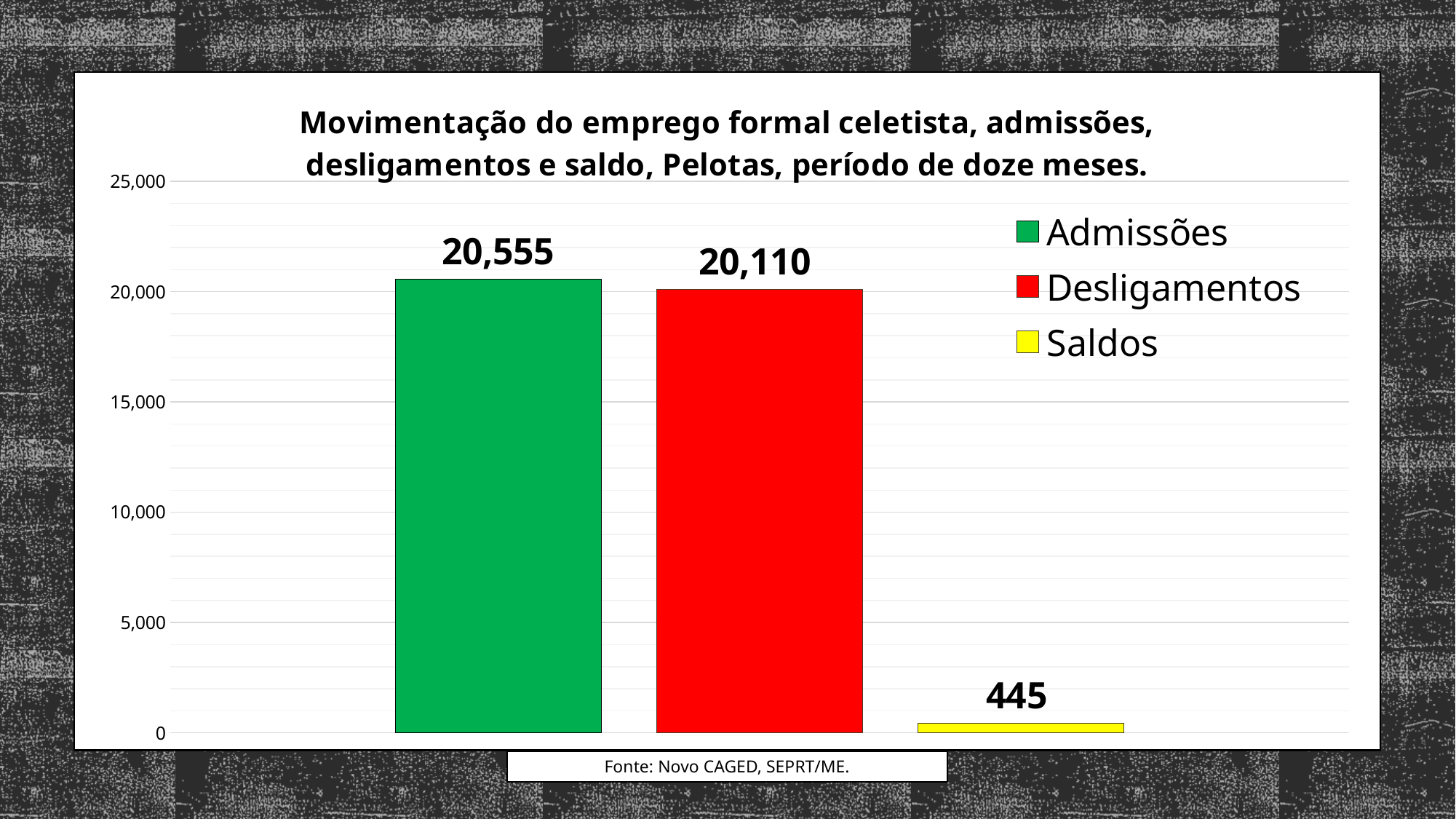
Is the value for Desligamentos greater or less than 15,000? greater What is the difference between Admissões and Desligamentos? 445 Which series has the lowest value? Saldos Is the value for Saldos greater or less than 5,000? less What colour is the bar for Saldos? yellow What kind of chart is shown? bar chart What is the value for Saldos? 445 Which series has the highest value? Admissões Which is larger, Desligamentos or Saldos? Desligamentos What is the value for Desligamentos? 20,110 What is the value for Admissões? 20,555 How many series does the legend list? 3